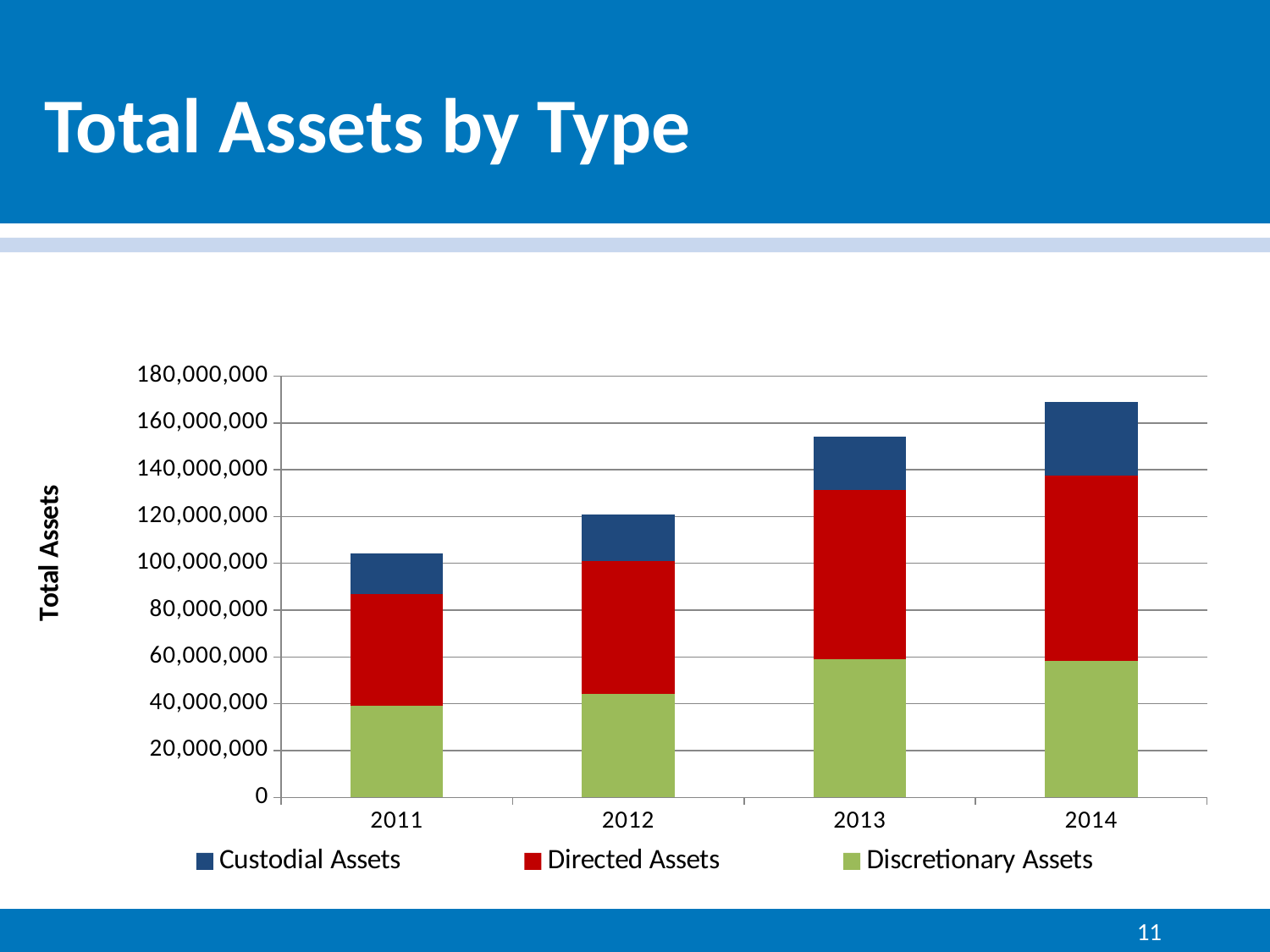
Is the total assets value for 2011 greater or less than 120,000,000? less Is the total assets value for 2014 greater or less than 160,000,000? greater Which year has the lowest total assets? 2011 Is the total assets value for 2013 greater or less than 160,000,000? less Which year has a larger Discretionary Assets value, 2012 or 2013? 2013 How many years are shown on the x axis of the chart? 4 What colour represents Directed Assets in the chart? Red Do total assets rise or fall from 2011 to 2014? Rise How many series does the chart's legend list? 3 What kind of chart is shown on the slide? Stacked bar chart Which year has larger total assets, 2012 or 2013? 2013 Which year has the highest total assets? 2014